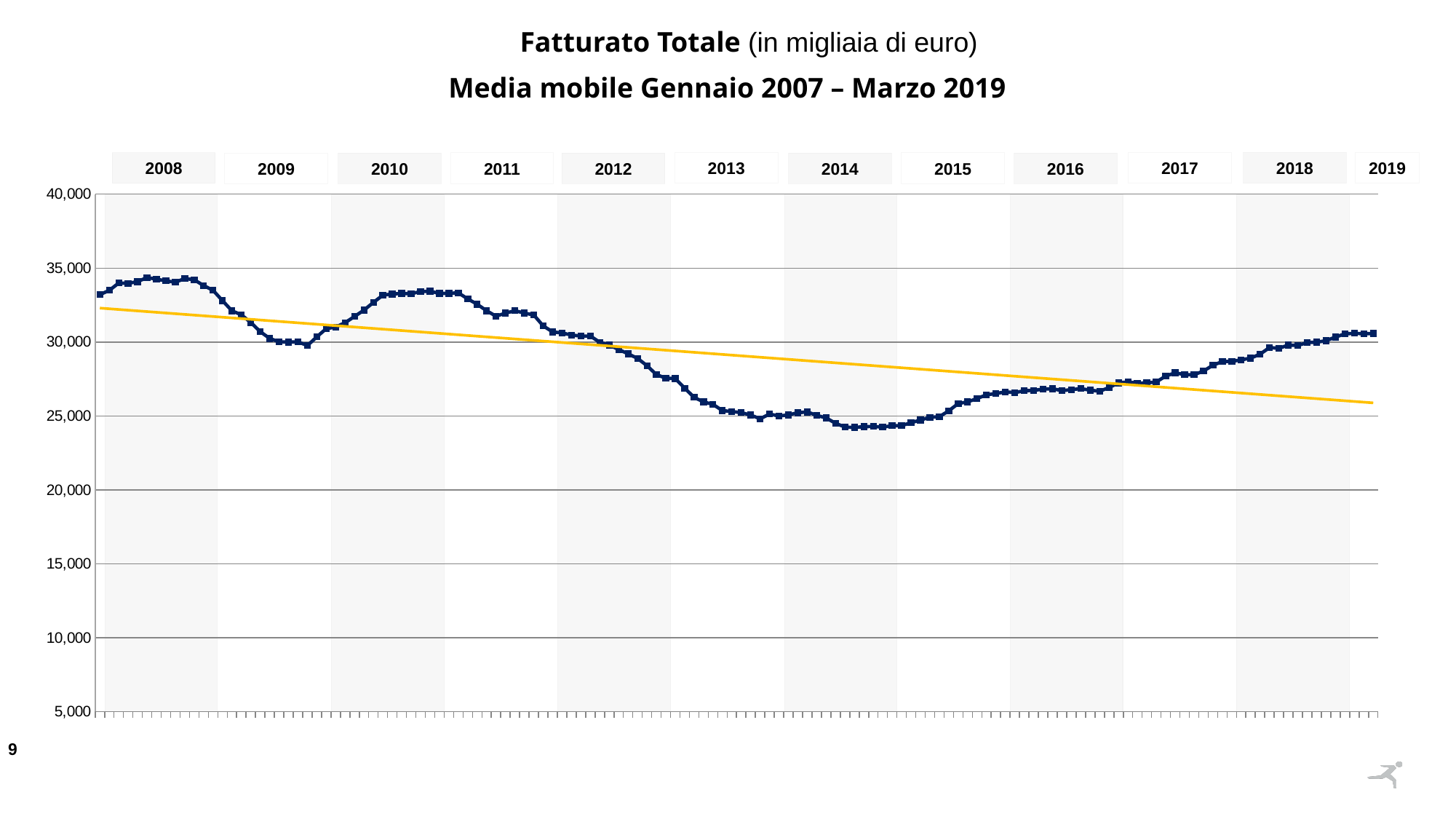
Which is larger, the moving average in 2008 or in 2014? 2008 In which labelled year does the moving average reach its lowest level? 2014 How many year labels are shown along the top of the chart? 12 Is the value of the moving average at the end of 2018 greater or less than 35,000? less Is the value of the moving average at the start of 2008 greater or less than 30,000? greater Does the yellow trend line rise or fall from left to right? fall Is the value of the moving average at the start of 2016 greater or less than 30,000? less What is the highest value shown on the vertical axis? 40,000 What kind of chart is shown on the slide? line chart In which labelled year does the moving average reach its highest level? 2008 What is the title of the chart? Fatturato Totale (in migliaia di euro) Media mobile Gennaio 2007 – Marzo 2019